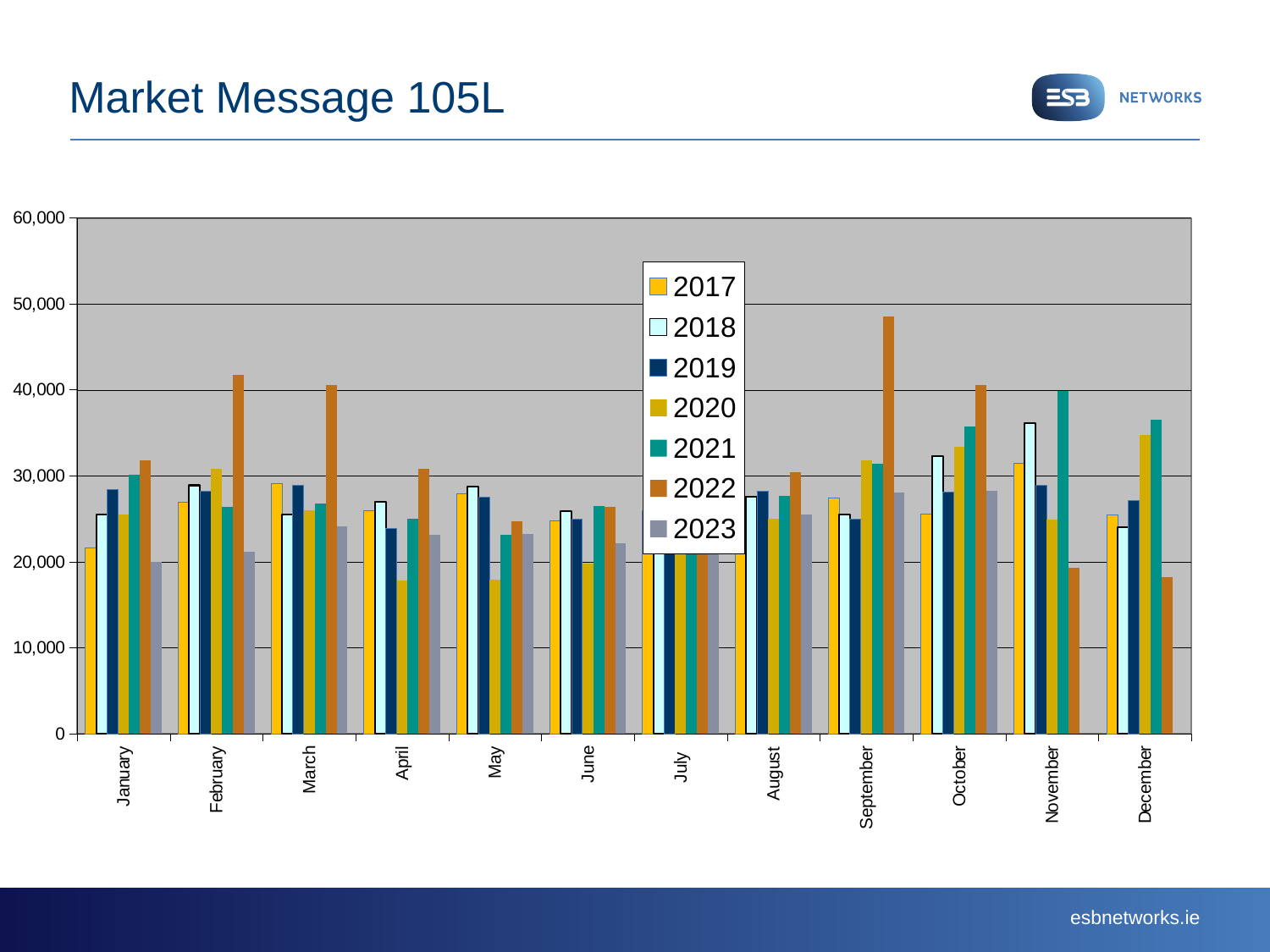
What kind of chart is shown on the slide? bar chart Is the value for 2022 in December greater or less than 20,000? less How many series does the legend list? 7 Is the value for 2022 in September greater or less than 40,000? greater In which month is the 2022 bar the highest? September What is the title of the slide containing the chart? Market Message 105L Which is larger, the 2022 value in April or the 2020 value in April? 2022 Which year has the highest bar in November? 2021 How many months are shown on the x axis? 12 Which year has the lowest bar in December? 2022 Which year has the lowest bar in April? 2020 Which year has the highest bar in September? 2022